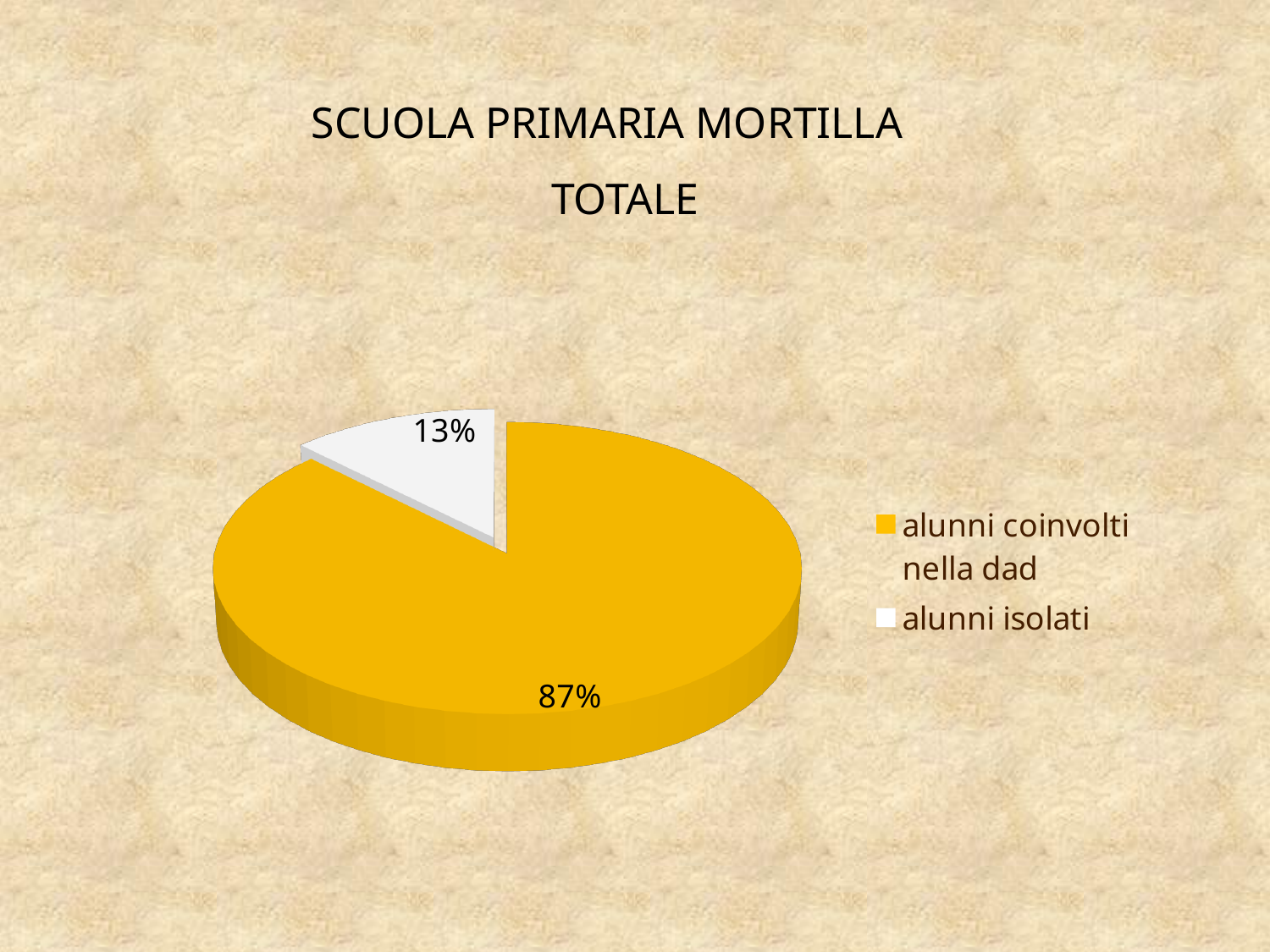
What is the title of the chart? SCUOLA PRIMARIA MORTILLA TOTALE What colour is the slice for "alunni isolati"? white What share of the pie is labelled "alunni isolati"? 13% What kind of chart is shown on the slide? pie chart How many entries does the legend list? 2 Which category has the largest slice of the pie? alunni coinvolti nella dad Which category has the smallest slice of the pie? alunni isolati What is the difference in percentage points between the "alunni coinvolti nella dad" slice and the "alunni isolati" slice? 74 Which is larger: the slice for "alunni coinvolti nella dad" or the slice for "alunni isolati"? alunni coinvolti nella dad How many slices does the pie chart have? 2 What share of the pie is labelled "alunni coinvolti nella dad"? 87%